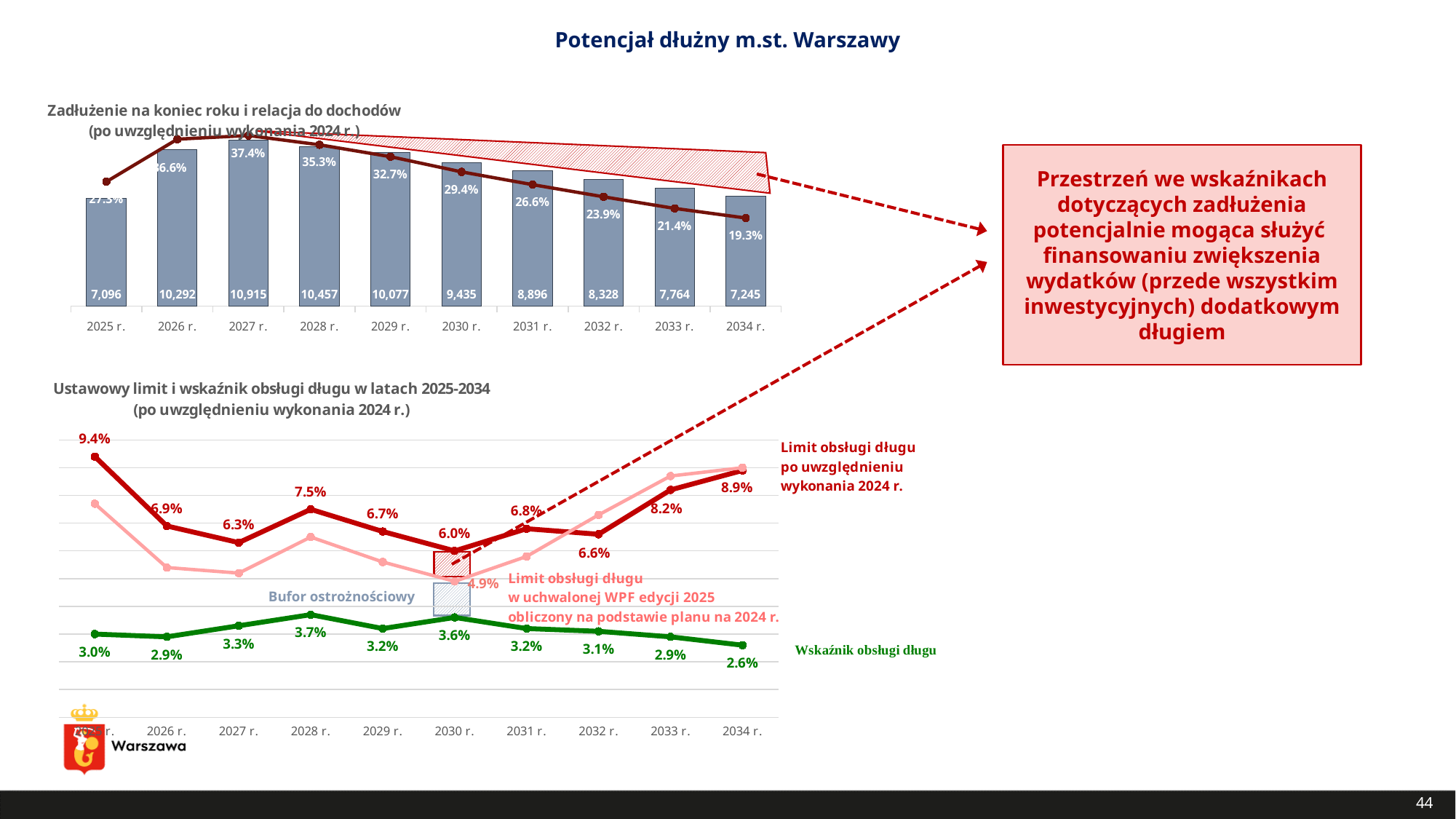
In the bottom chart 'Ustawowy limit i wskaźnik obsługi długu w latach 2025-2034', what is the value of 'Wskaźnik obsługi długu' for 2030 r.? 3.6% In the bottom chart 'Ustawowy limit i wskaźnik obsługi długu w latach 2025-2034', what is the value of 'Limit obsługi długu po uwzględnieniu wykonania 2024 r.' for 2028 r.? 7.5% In the top chart 'Zadłużenie na koniec roku i relacja do dochodów', what is the difference between the bar values for 2026 r. and 2034 r.? 3,047 In the top chart 'Zadłużenie na koniec roku i relacja do dochodów', what is the percentage shown on the line for 2034 r.? 19.3% In the bottom chart 'Ustawowy limit i wskaźnik obsługi długu w latach 2025-2034', what is the difference between 'Limit obsługi długu po uwzględnieniu wykonania 2024 r.' and 'Wskaźnik obsługi długu' in 2025 r.? 6.4% In the bottom chart 'Ustawowy limit i wskaźnik obsługi długu w latach 2025-2034', in which year is 'Wskaźnik obsługi długu' highest? 2028 r. In the top chart 'Zadłużenie na koniec roku i relacja do dochodów', how many years are shown on the x axis? 10 In the top chart 'Zadłużenie na koniec roku i relacja do dochodów', does the percentage line rise or fall from 2027 r. to 2034 r.? fall What kind of chart is the bottom chart 'Ustawowy limit i wskaźnik obsługi długu w latach 2025-2034'? line chart In the top chart 'Zadłużenie na koniec roku i relacja do dochodów', which year has the highest bar value? 2027 r. In the top chart 'Zadłużenie na koniec roku i relacja do dochodów', what is the bar value for 2027 r.? 10,915 In the top chart 'Zadłużenie na koniec roku i relacja do dochodów', which year has the lowest bar value? 2025 r.